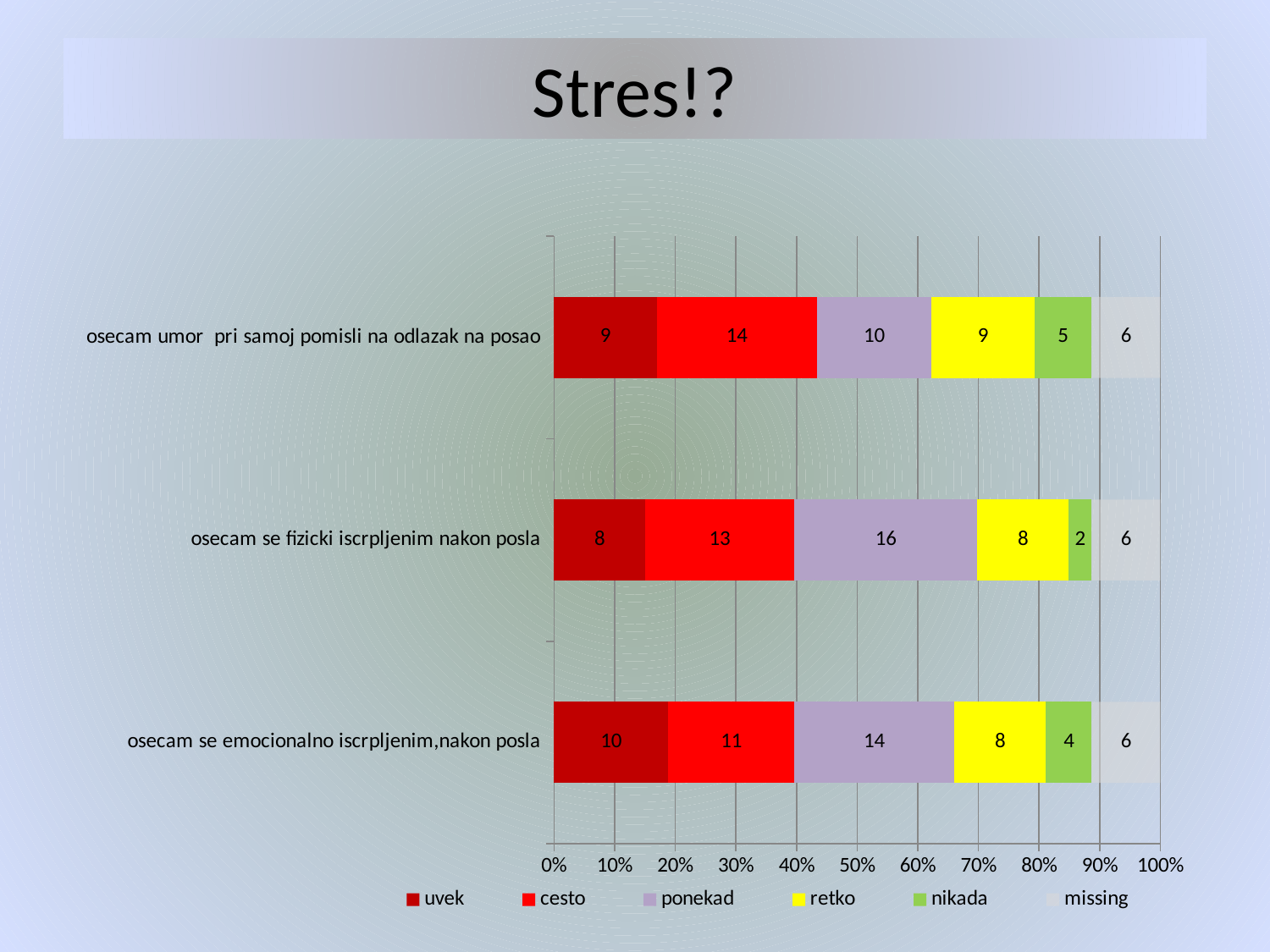
What is the 'ponekad' value for 'osecam se fizicki iscrpljenim nakon posla'? 16 What is the 'uvek' value for 'osecam se emocionalno iscrpljenim,nakon posla'? 10 Which is larger: the 'uvek' value for 'osecam se emocionalno iscrpljenim,nakon posla' or the 'uvek' value for 'osecam se fizicki iscrpljenim nakon posla'? osecam se emocionalno iscrpljenim,nakon posla Which category has the lowest 'nikada' value? osecam se fizicki iscrpljenim nakon posla What is the 'cesto' value for 'osecam umor pri samoj pomisli na odlazak na posao'? 14 What is the difference between the 'cesto' values for 'osecam umor pri samoj pomisli na odlazak na posao' and 'osecam se emocionalno iscrpljenim,nakon posla'? 3 What kind of chart is shown on the slide? stacked bar chart What is the total of all segments in the bar for 'osecam se emocionalno iscrpljenim,nakon posla'? 53 How many series does the legend list? 6 What is the 'nikada' value for 'osecam se fizicki iscrpljenim nakon posla'? 2 How many categories (bars) are plotted in the chart? 3 Which category has the highest 'ponekad' value? osecam se fizicki iscrpljenim nakon posla